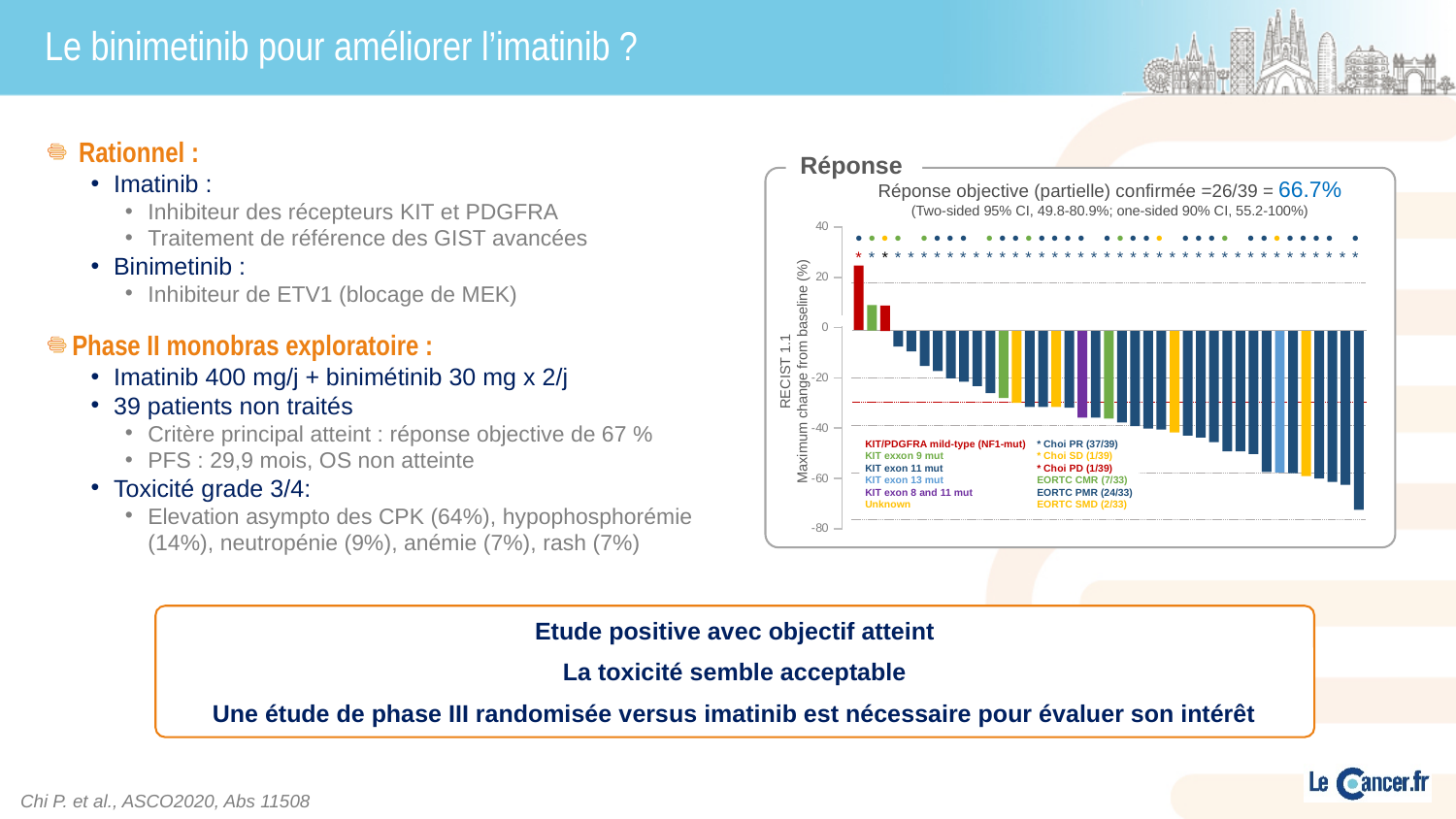
In the "Réponse" chart, which bar has the lowest value: the leftmost bar or the rightmost bar? The rightmost bar In the "Réponse" chart, what is the label of the y axis? Maximum change from baseline (%) In the "Réponse" chart, is the value of the leftmost (tallest positive) bar greater or less than 20? greater In the "Réponse" chart, how many patients are represented according to the denominator in the chart title? 39 What kind of chart is shown under the heading "Réponse"? Bar chart In the "Réponse" chart, how many patients out of the total had a confirmed objective response, as written in the chart title? 26/39 In the "Réponse" chart, do the bar values rise or fall from left to right along the x axis? Fall In the "Réponse" chart, is the value of the rightmost bar greater or less than -60? less In the "Réponse" chart, which is larger: the value of the leftmost bar or the value of the rightmost bar? The leftmost bar In the "Réponse" chart, what is the lowest tick value shown on the y axis? -80 In the "Réponse" chart, is the value of the second bar from the left greater or less than 20? less In the "Réponse" chart, what confirmed objective (partial) response rate is stated in the chart title? 66.7%